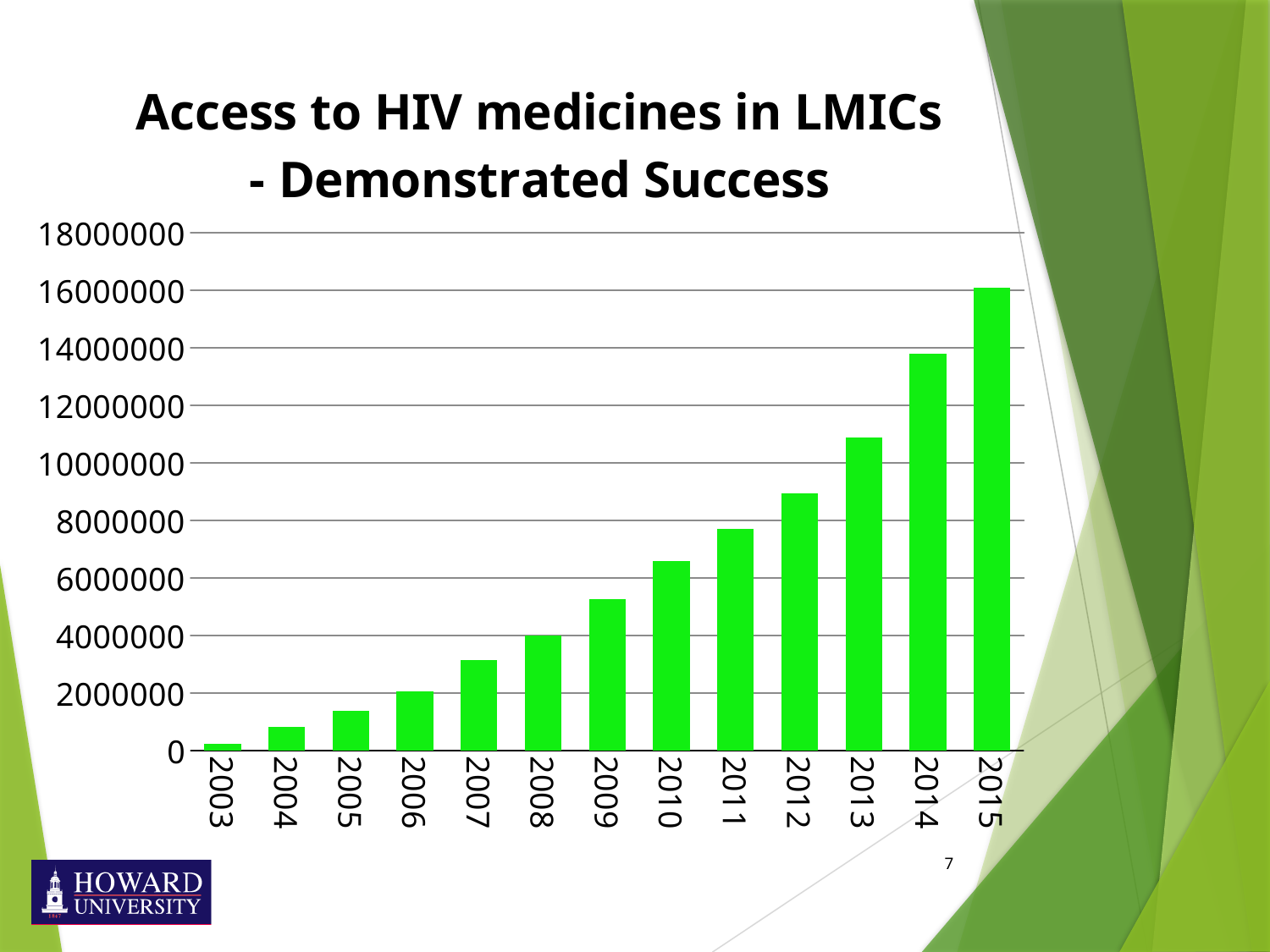
What kind of chart is shown on the slide? bar chart What is the title of the chart on the slide? Access to HIV medicines in LMICs - Demonstrated Success Is the value for 2003 greater or less than 2000000? less Is the value for 2014 greater or less than 12000000? greater Do the values rise or fall from 2003 to 2015? rise Is the value for 2012 greater or less than 10000000? less Which year has the larger value, 2009 or 2011? 2011 Which year has the lowest bar in the chart? 2003 Which year has the highest bar in the chart? 2015 How many years are plotted on the x axis of the chart? 13